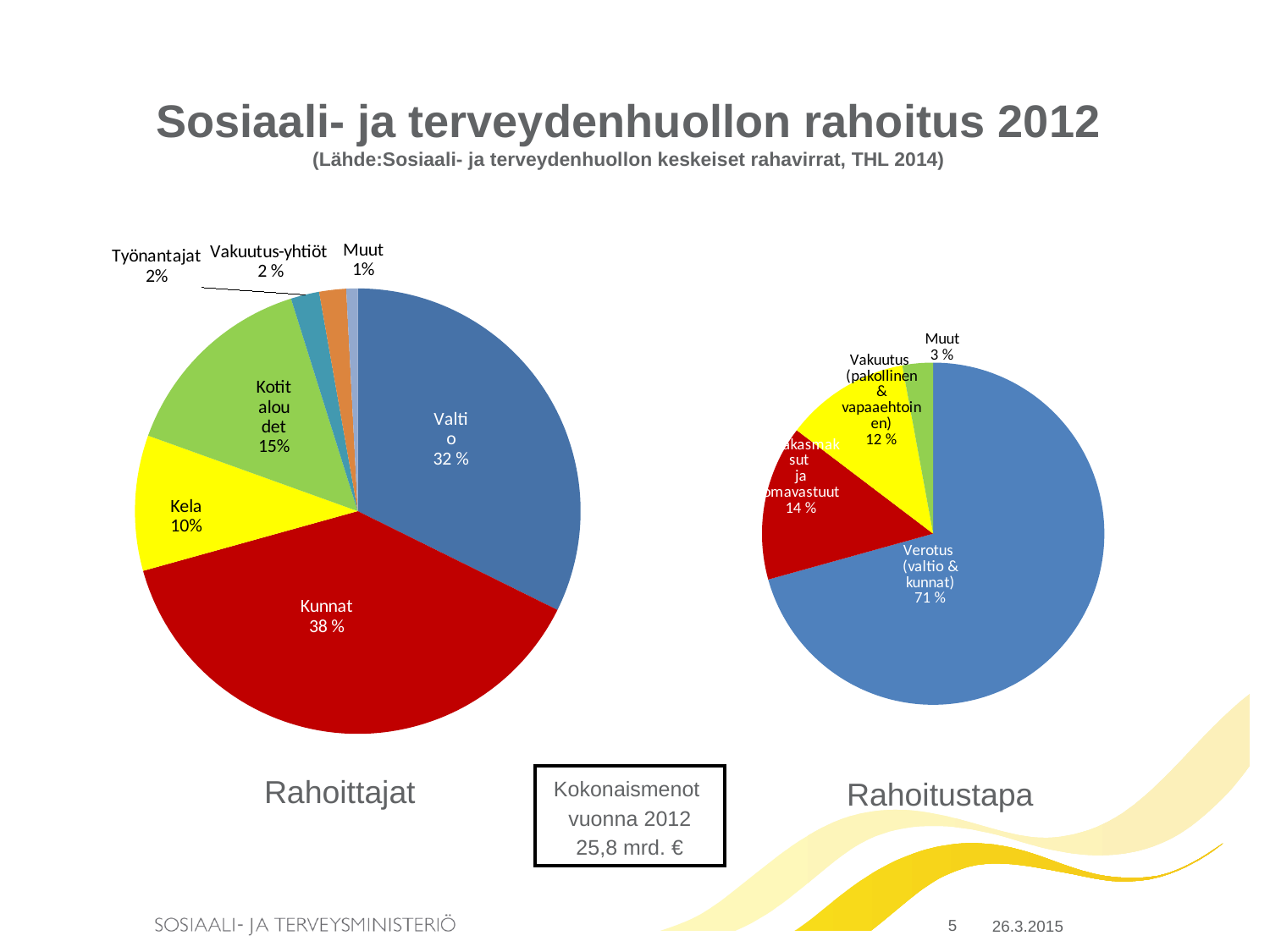
In the Rahoitustapa pie chart, what share is shown for Vakuutus (pakollinen & vapaaehtoinen)? 12 % In the Rahoittajat pie chart, how many slices are there? 7 In the Rahoittajat pie chart, which category has the largest share? Kunnat In the Rahoitustapa pie chart, which category has the largest share? Verotus (valtio & kunnat) In the Rahoittajat pie chart, which category has the smallest share? Muut In the Rahoittajat pie chart, what share is shown for Valtio? 32 % In the Rahoitustapa pie chart, how many slices are there? 4 In the Rahoitustapa pie chart, what share is shown for Verotus (valtio & kunnat)? 71 % In the Rahoittajat pie chart, what share is shown for Kunnat? 38 % In the Rahoittajat pie chart, how many percentage points larger is the Kunnat share than the Valtio share? 6 What type of chart is used for Rahoittajat and Rahoitustapa? Pie chart In the Rahoittajat pie chart, what share is shown for Kela? 10%